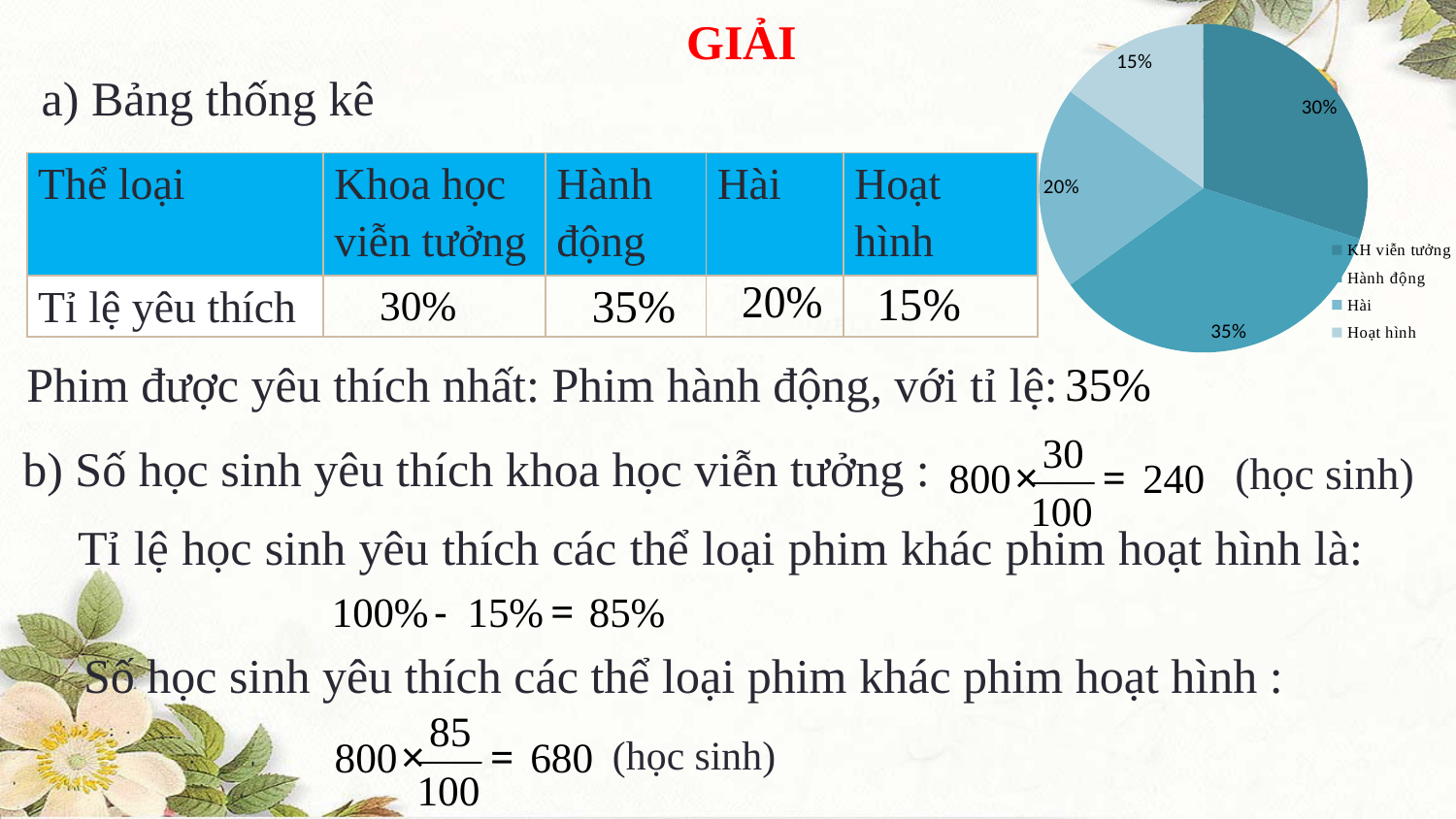
In the pie chart, what share is shown for Hoạt hình? 15% In the pie chart, which is larger: the share for KH viễn tưởng or the share for Hài? KH viễn tưởng Which category has the smallest slice in the pie chart? Hoạt hình In the pie chart, what share is shown for Hành động? 35% In the pie chart, what is the difference between the shares for Hành động and Hoạt hình? 20% How many slices does the pie chart have? 4 What is the first entry listed in the pie chart's legend? KH viễn tưởng In the pie chart, what share is shown for Hài? 20% How many entries does the pie chart's legend list? 4 What kind of chart is shown on the slide? pie chart Which category has the largest slice in the pie chart? Hành động In the pie chart, what share is shown for KH viễn tưởng? 30%